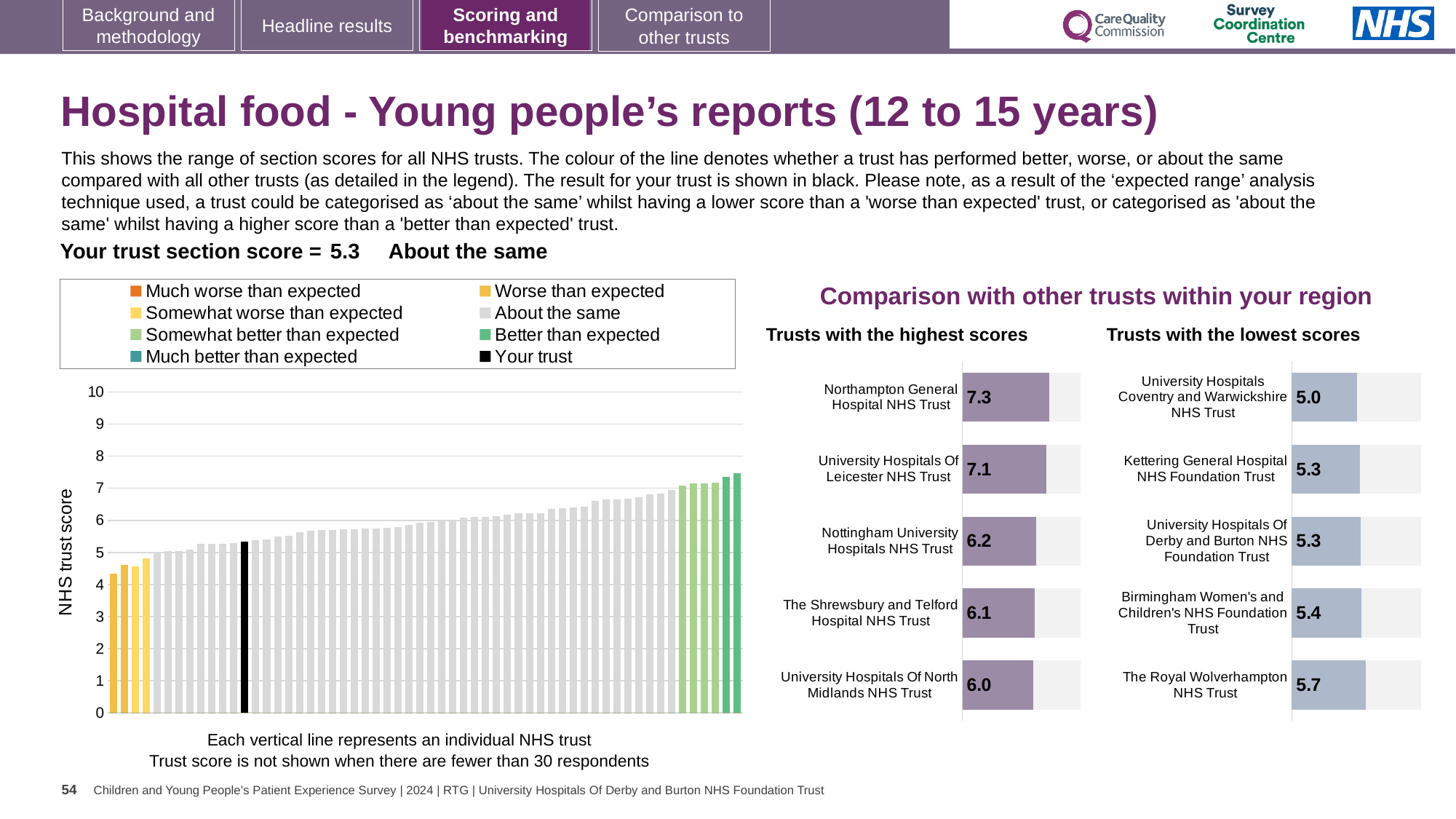
In the 'Trusts with the highest scores' chart, which trust has the lowest score? University Hospitals Of North Midlands NHS Trust How many trusts are listed in the 'Trusts with the highest scores' chart? 5 In the main NHS trust score chart on the left, do the bar values rise or fall from left to right? rise In the main NHS trust score chart on the left, what is the score of the black bar representing your trust? 5.3 In the 'Trusts with the highest scores' chart, what is the difference between the scores of Northampton General Hospital NHS Trust and University Hospitals Of Leicester NHS Trust? 0.2 In the 'Trusts with the lowest scores' chart, which trust has the highest score? The Royal Wolverhampton NHS Trust In the 'Trusts with the highest scores' chart, what is the score for Northampton General Hospital NHS Trust? 7.3 How many entries does the legend above the main NHS trust score chart list? 8 In the 'Trusts with the lowest scores' chart, what is the score for University Hospitals Coventry and Warwickshire NHS Trust? 5.0 In the main NHS trust score chart on the left, is the value of the tallest bar greater or less than 8? less In the 'Trusts with the lowest scores' chart, which has the larger score: Birmingham Women's and Children's NHS Foundation Trust or Kettering General Hospital NHS Foundation Trust? Birmingham Women's and Children's NHS Foundation Trust What kind of chart is the main chart on the left showing NHS trust scores? bar chart